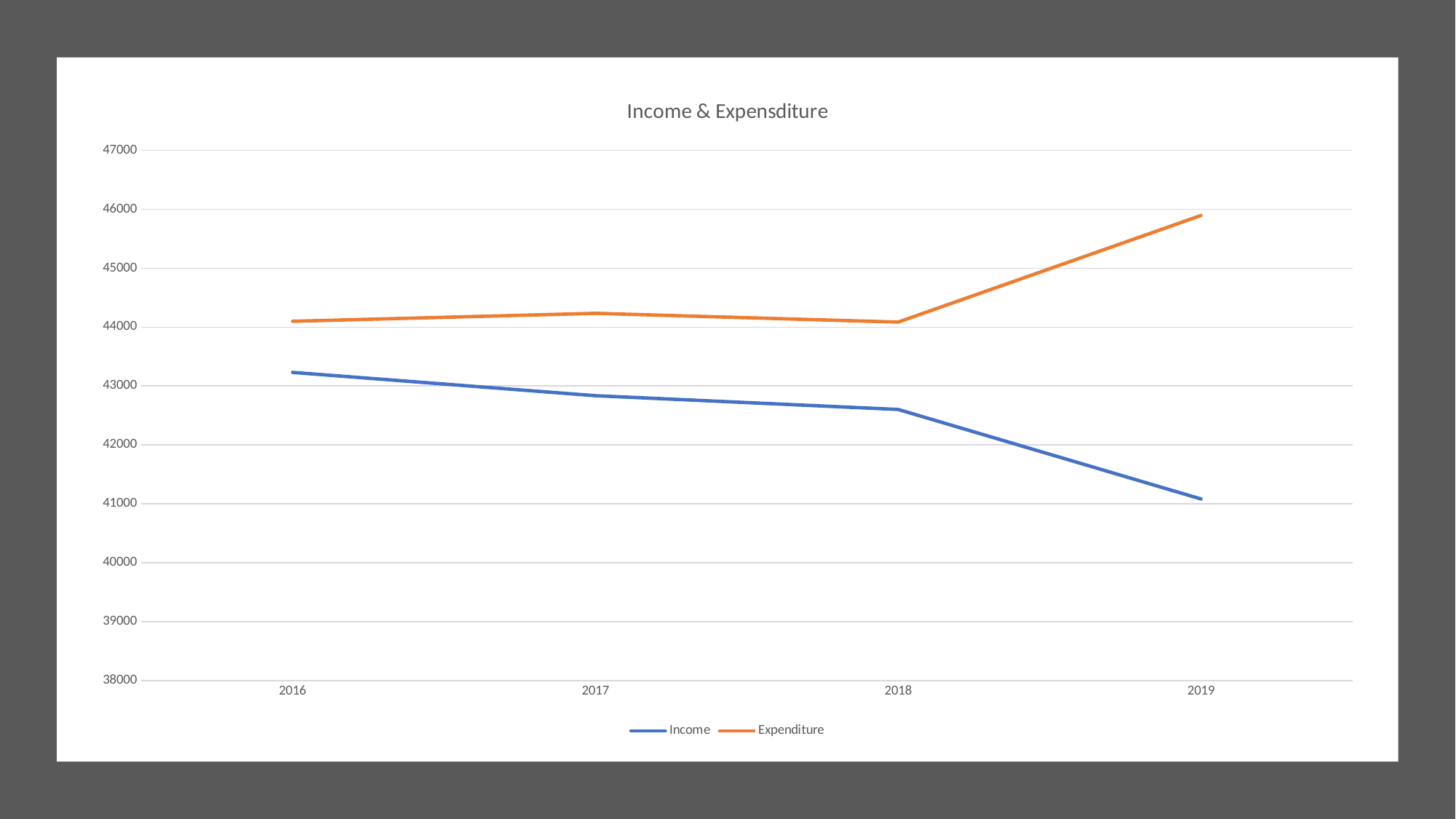
In 2019, which is larger, Income or Expenditure? Expenditure Does the Income line rise or fall from 2016 to 2019? fall Is the value for Expenditure in 2018 greater or less than 45000? less How many years are plotted along the x axis? 4 In which year is Expenditure highest? 2019 In which year is Income lowest? 2019 Which colour is used for the Expenditure line? orange How many series does the legend list? 2 What is the title of the chart? Income & Expensditure Is the value for Expenditure in 2019 greater or less than 45000? greater Is the value for Income in 2019 greater or less than 42000? less What kind of chart is shown on the slide? line chart